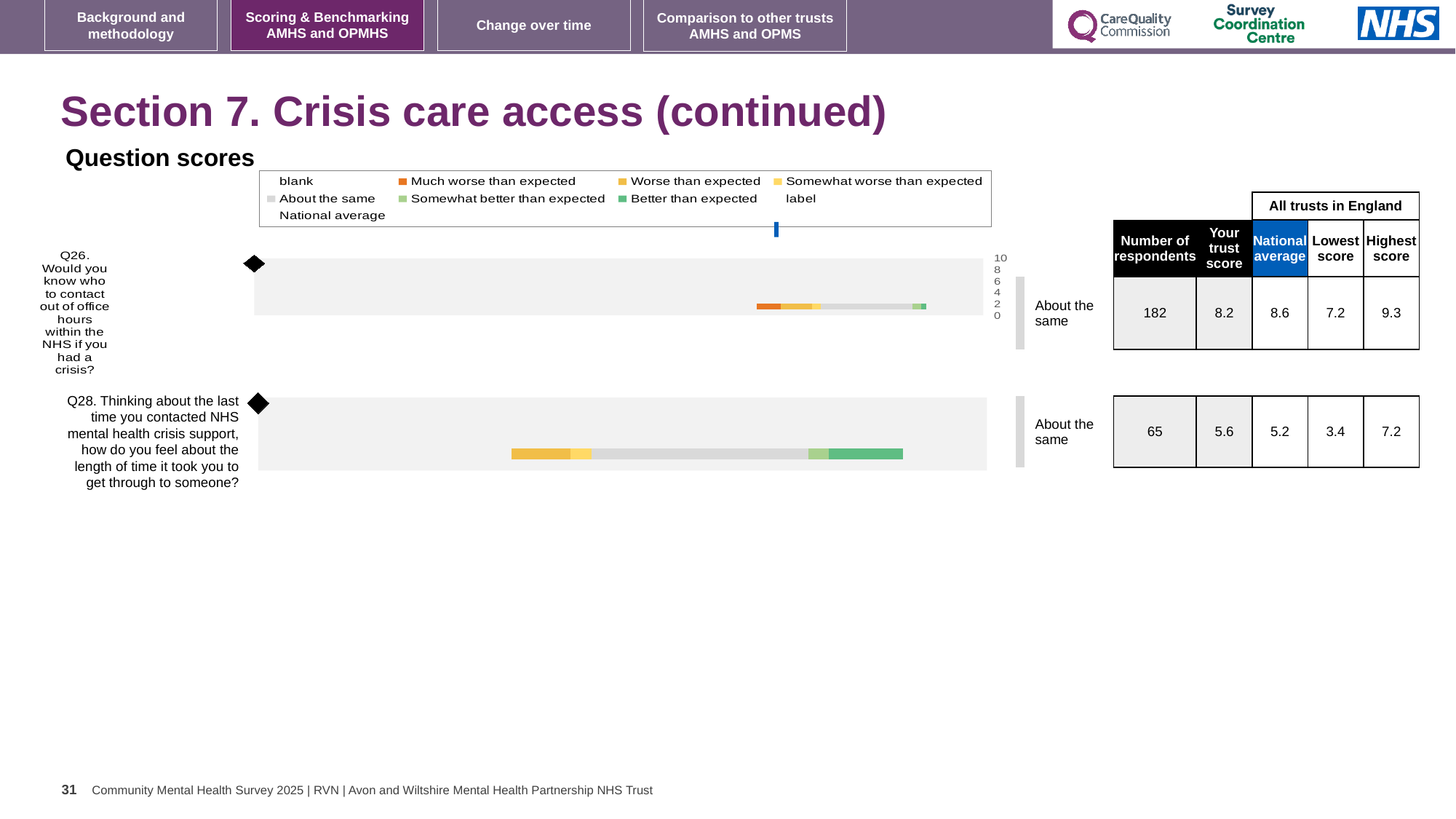
What is the national average score for Q26? 8.6 What benchmark category label is shown next to the Q26 bar? About the same What is the difference between the national average and the trust score for Q26? 0.4 How many questions are plotted in the question scores chart? 2 Which question had more respondents, Q26 or Q28? Q26 How many respondents answered Q28? 65 What is the highest score among all trusts in England for Q28? 7.2 What is the 'Your trust score' value for Q26? 8.2 What kind of chart is used to show the question scores on this slide? bar chart What is the difference between the highest and lowest scores for Q28? 3.8 For Q28, which is larger: the trust score or the national average? the trust score What is the lowest score among all trusts in England for Q26? 7.2